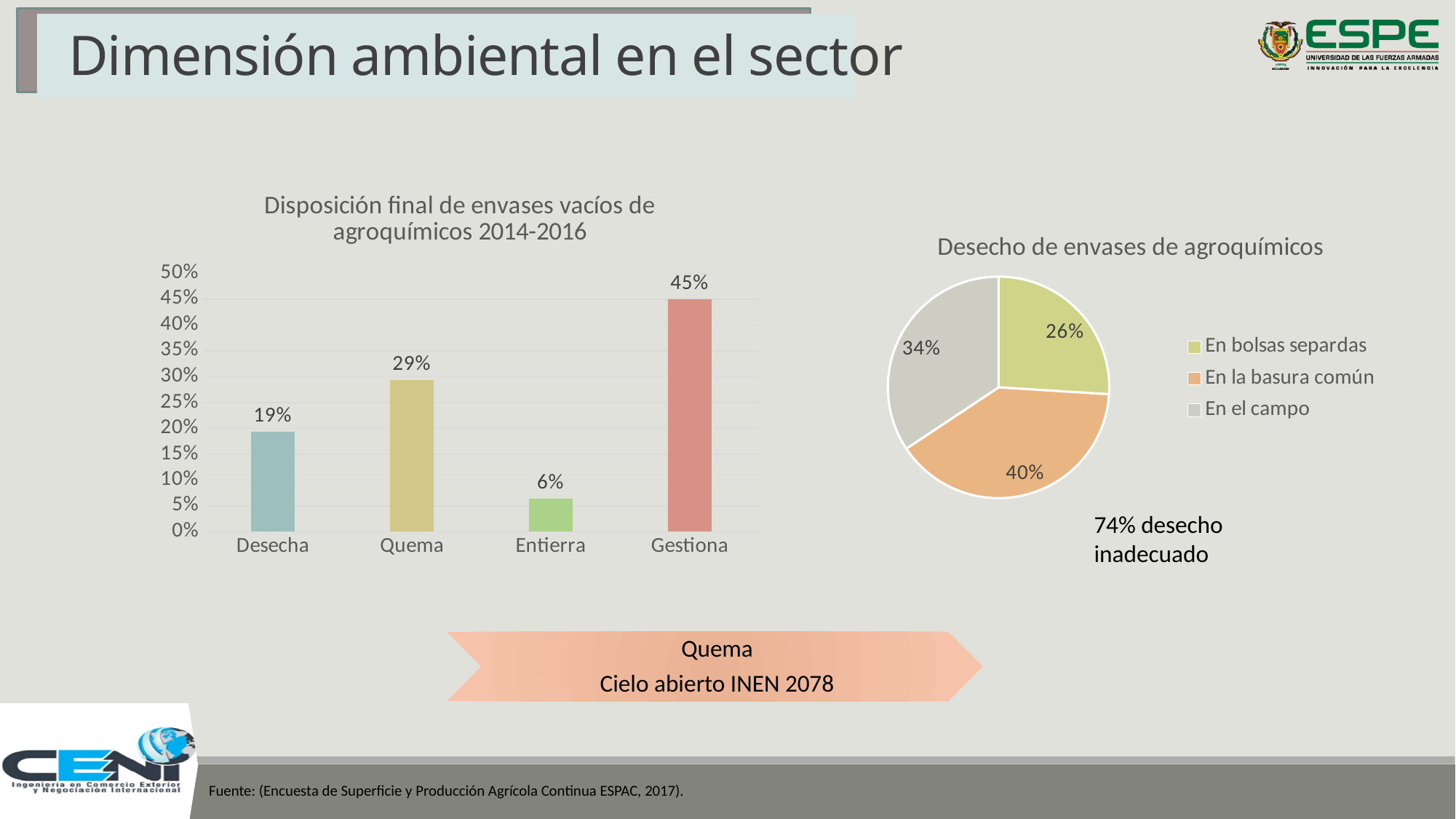
In the 'Disposición final de envases vacíos de agroquímicos 2014-2016' chart, what is the value for Quema? 29% In the 'Disposición final de envases vacíos de agroquímicos 2014-2016' chart, which category has the highest value? Gestiona In the 'Disposición final de envases vacíos de agroquímicos 2014-2016' chart, which category has the lowest value? Entierra In the 'Desecho de envases de agroquímicos' chart, which slice is the largest? En la basura común In the 'Desecho de envases de agroquímicos' chart, what share is 'En bolsas separdas'? 26% In the 'Desecho de envases de agroquímicos' chart, what share is 'En la basura común'? 40% How many categories are shown in the 'Disposición final de envases vacíos de agroquímicos 2014-2016' chart? 4 How many entries does the legend of the 'Desecho de envases de agroquímicos' chart list? 3 In the 'Disposición final de envases vacíos de agroquímicos 2014-2016' chart, what is the value for Entierra? 6% In the 'Disposición final de envases vacíos de agroquímicos 2014-2016' chart, which is larger, Desecha or Quema? Quema What kind of chart is 'Disposición final de envases vacíos de agroquímicos 2014-2016'? Bar chart In the 'Disposición final de envases vacíos de agroquímicos 2014-2016' chart, what is the difference between Gestiona and Desecha? 26%